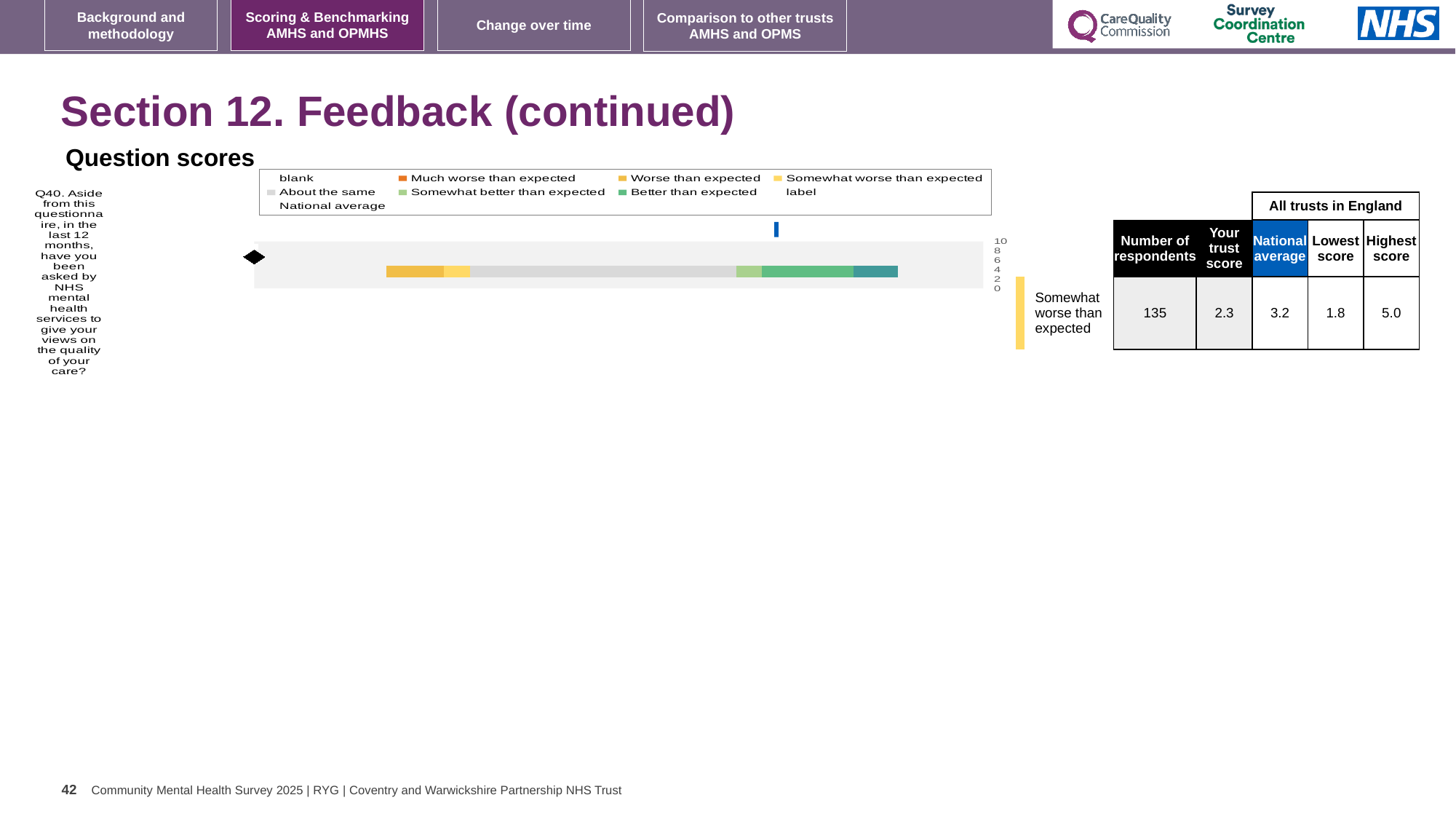
What is the number of respondents shown for Q40? 135 What is the difference between the national average and the trust score for Q40? 0.9 What is the national average score for Q40? 3.2 Which is larger for Q40, the trust score or the national average? national average What kind of chart is used to show the Q40 question score? bar chart What colour does the legend use for 'Much worse than expected'? orange What is the lowest score among all trusts in England for Q40? 1.8 What is the difference between the highest and lowest scores among all trusts in England for Q40? 3.2 What is the highest score among all trusts in England for Q40? 5.0 Which benchmark category is the trust's Q40 score placed in? Somewhat worse than expected Which question is plotted in the chart? Q40 What is the trust's score for Q40? 2.3